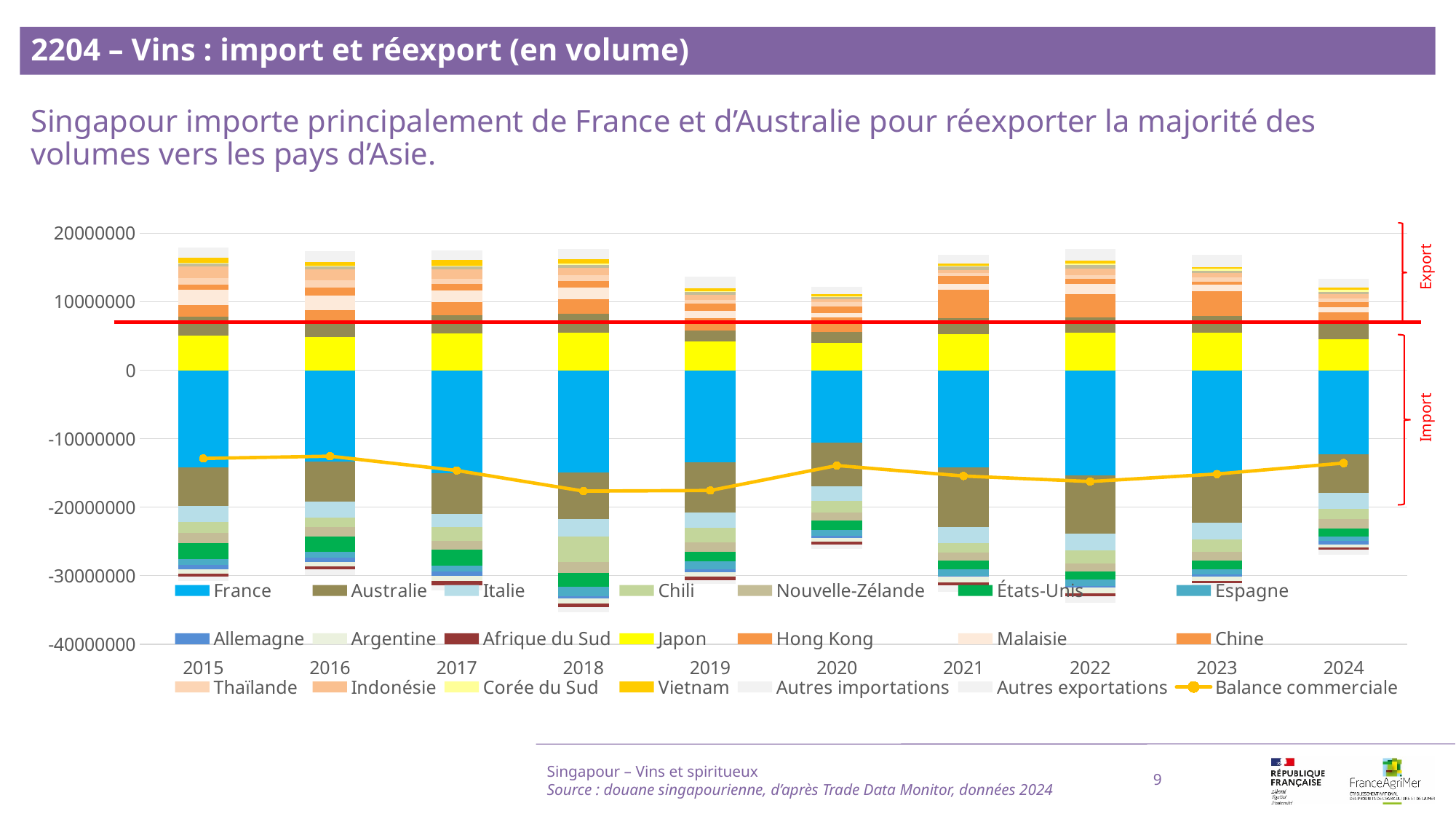
Which series is plotted as a line with markers rather than as stacked bars? Balance commerciale How many years are shown on the x axis of the chart? 10 What is the title of the slide containing the chart? 2204 – Vins : import et réexport (en volume) Which year has the highest (least negative) value on the Balance commerciale line? 2016 How many series does the chart legend list? 21 Is the total height of the positive (export) stacked bar in 2019 greater or less than 10000000? greater What kind of chart is shown on the slide? combination bar and line chart (stacked bars with a line) Which year has the taller positive (export) stacked bar, 2019 or 2021? 2021 Is the value of the Balance commerciale line in 2018 greater or less than -10000000? less Is the total height of the positive (export) stacked bar in 2024 greater or less than 20000000? less Does the Balance commerciale line rise or fall from 2015 to 2018? fall